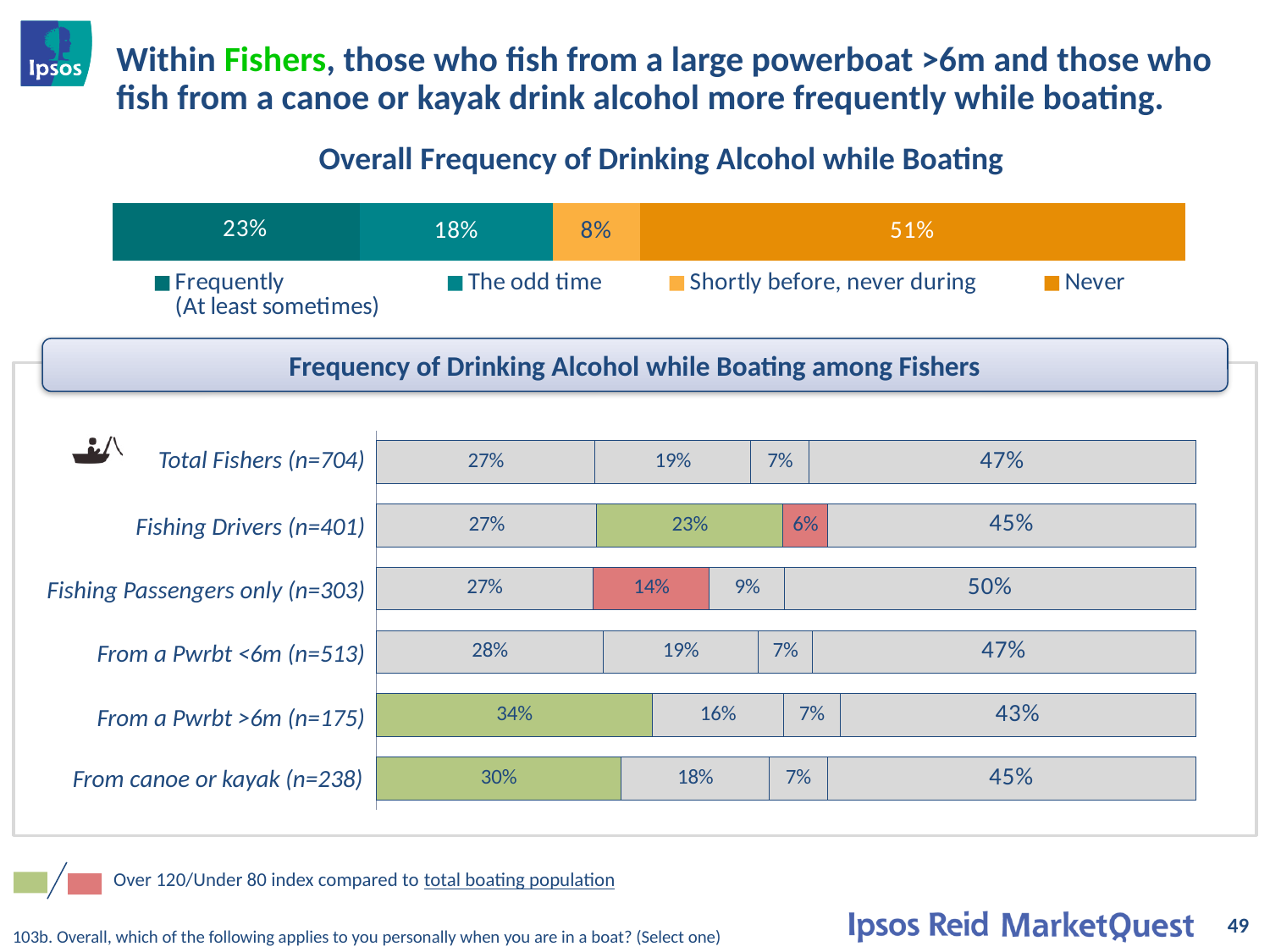
In the 'Overall Frequency of Drinking Alcohol while Boating' chart, what percentage is shown for 'Frequently (At least sometimes)'? 23% In the 'Frequency of Drinking Alcohol while Boating among Fishers' chart, how many groups (bars) are shown? 6 What type of chart is the 'Frequency of Drinking Alcohol while Boating among Fishers' chart? Stacked bar chart How many series does the legend of the 'Overall Frequency of Drinking Alcohol while Boating' chart list? 4 In the 'Frequency of Drinking Alcohol while Boating among Fishers' chart, which group has the highest first-segment (Frequently) value? From a Pwrbt >6m (n=175) In the 'Frequency of Drinking Alcohol while Boating among Fishers' chart, what is the first (Frequently) value for 'From a Pwrbt >6m (n=175)'? 34% In the 'Overall Frequency of Drinking Alcohol while Boating' chart, what percentage is shown for 'Never'? 51% In the 'Overall Frequency of Drinking Alcohol while Boating' chart, which category has the smallest share? Shortly before, never during In the 'Frequency of Drinking Alcohol while Boating among Fishers' chart, what is the last (Never) value for 'Fishing Passengers only (n=303)'? 50% In the 'Frequency of Drinking Alcohol while Boating among Fishers' chart, is the first-segment value for 'From canoe or kayak (n=238)' larger or smaller than that for 'Total Fishers (n=704)'? Larger In the 'Frequency of Drinking Alcohol while Boating among Fishers' chart, which group has the lowest last-segment (Never) value? From a Pwrbt >6m (n=175) In the 'Frequency of Drinking Alcohol while Boating among Fishers' chart, what is the difference between the second-segment values for 'Fishing Drivers (n=401)' and 'Fishing Passengers only (n=303)'? 9%